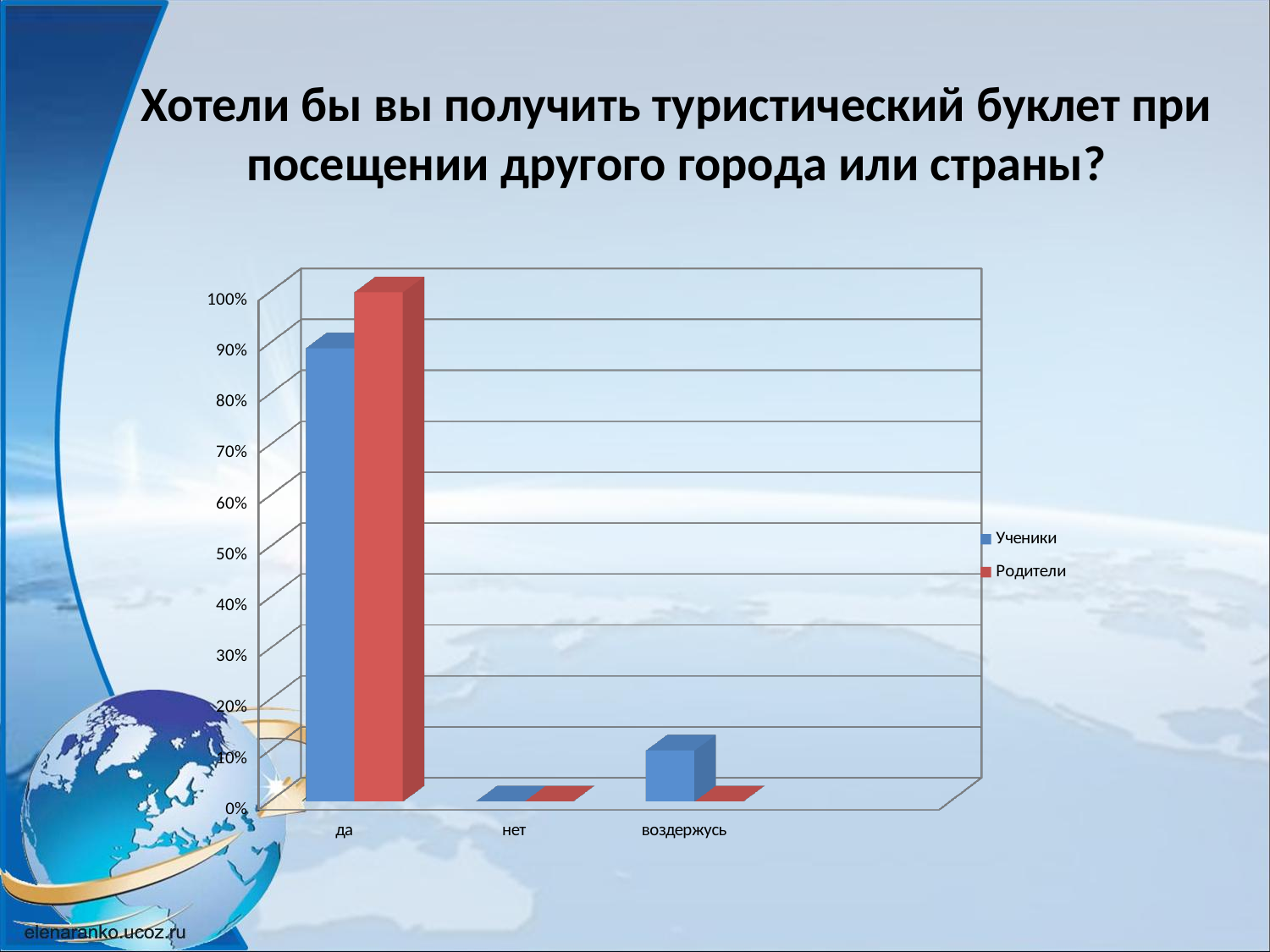
Is the value for Ученики in the category воздержусь greater or less than 20%? less Is the value for Родители in the category да greater or less than 90%? greater For the category да, which series has the larger value, Ученики or Родители? Родители How many answer categories are shown on the x axis? 3 What are the two series named in the legend? Ученики and Родители Is the value for Ученики in the category да greater or less than 80%? greater Which category has the highest value for Родители? да What kind of chart is shown on the slide? bar chart Which category has the highest value for Ученики? да How many series does the legend list? 2 Which category has the lowest value for Ученики? нет What is the value for Родители in the category нет? 0%